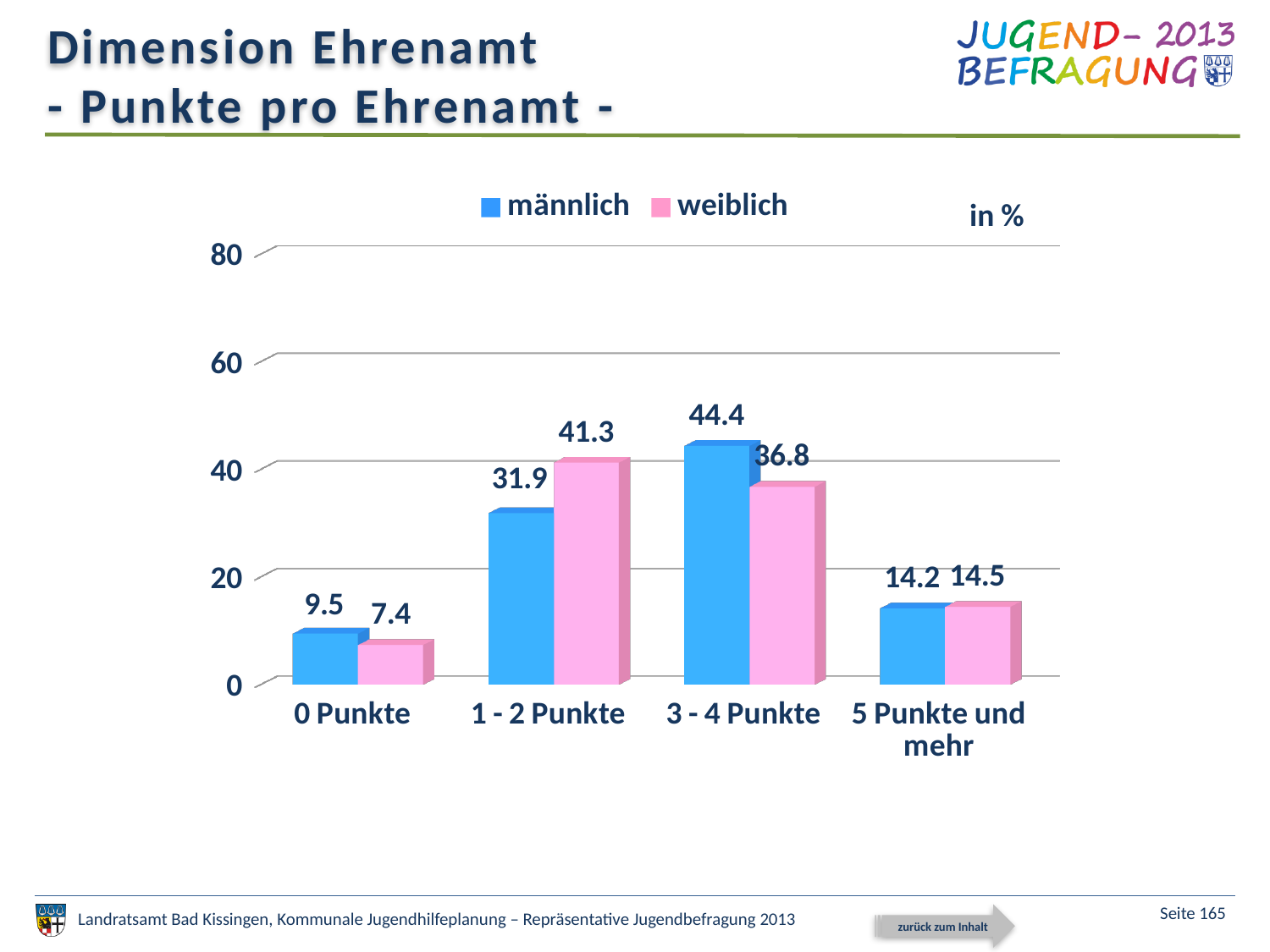
Which category has the highest value for männlich? 3 - 4 Punkte What is the difference between the weiblich and männlich values in the 1 - 2 Punkte category? 9.4 How many categories are shown on the x axis? 4 In the 0 Punkte category, which series has the larger value, männlich or weiblich? männlich What kind of chart is shown on the slide? bar chart What is the value for männlich in the 1 - 2 Punkte category? 31.9 What is the difference between the männlich and weiblich values in the 3 - 4 Punkte category? 7.6 What is the value for weiblich in the 0 Punkte category? 7.4 Which category has the lowest value for weiblich? 0 Punkte How many series does the legend list? 2 What unit is indicated for the values in the chart? in % What is the value for weiblich in the 3 - 4 Punkte category? 36.8